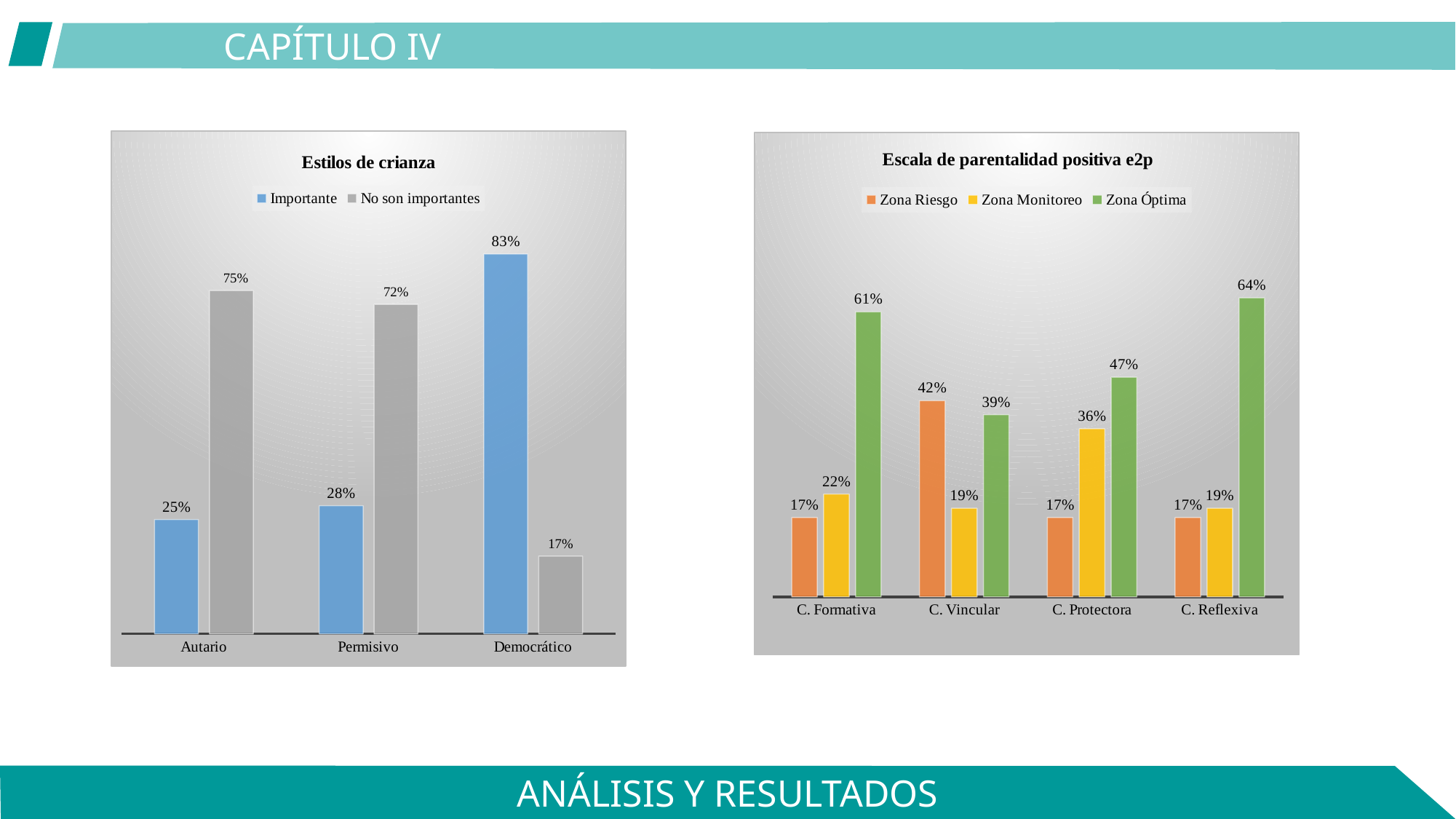
In the 'Estilos de crianza' chart, what is the value of 'Importante' for Democrático? 83% In the 'Escala de parentalidad positiva e2p' chart, what is the difference between 'Zona Óptima' and 'Zona Monitoreo' for C. Formativa? 39% In the 'Estilos de crianza' chart, what is the difference between 'No son importantes' and 'Importante' for Permisivo? 44% In the 'Escala de parentalidad positiva e2p' chart, what is the 'Zona Riesgo' value for C. Vincular? 42% What type of chart is 'Escala de parentalidad positiva e2p'? Bar chart In the 'Estilos de crianza' chart, how many series does the legend list? 2 In the 'Escala de parentalidad positiva e2p' chart, which is larger for C. Protectora: 'Zona Monitoreo' or 'Zona Óptima'? Zona Óptima In the 'Escala de parentalidad positiva e2p' chart, which category has the lowest 'Zona Óptima' value? C. Vincular In the 'Estilos de crianza' chart, what is the value of 'No son importantes' for Autario? 75% In the 'Escala de parentalidad positiva e2p' chart, what is the 'Zona Óptima' value for C. Reflexiva? 64% In the 'Estilos de crianza' chart, which category has the highest 'Importante' value? Democrático In the 'Estilos de crianza' chart, how many categories are shown on the x axis? 3